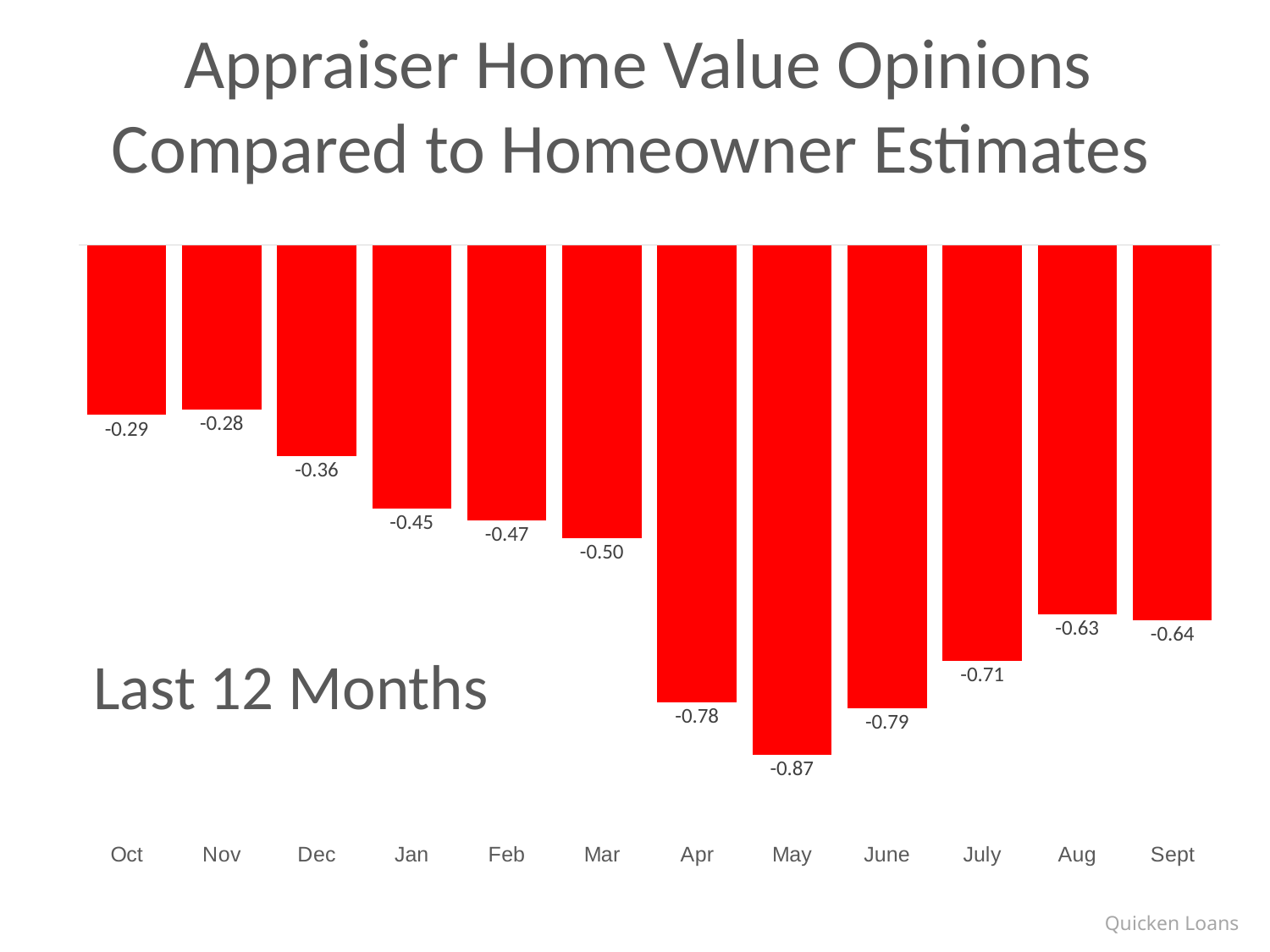
What is the value for Sept? -0.64 What is the title of the chart? Appraiser Home Value Opinions Compared to Homeowner Estimates Which is larger, the value for Dec or the value for Jan? Dec What is the value for May? -0.87 Which month has the lowest (most negative) value? May What is the value for Oct? -0.29 What colour are the bars on the chart? Red Do the values generally rise or fall from Oct to May? Fall What is the difference between the values for Apr and Mar? 0.28 What kind of chart is shown on the slide? Bar chart Which month has the highest (least negative) value? Nov How many months are shown on the chart? 12